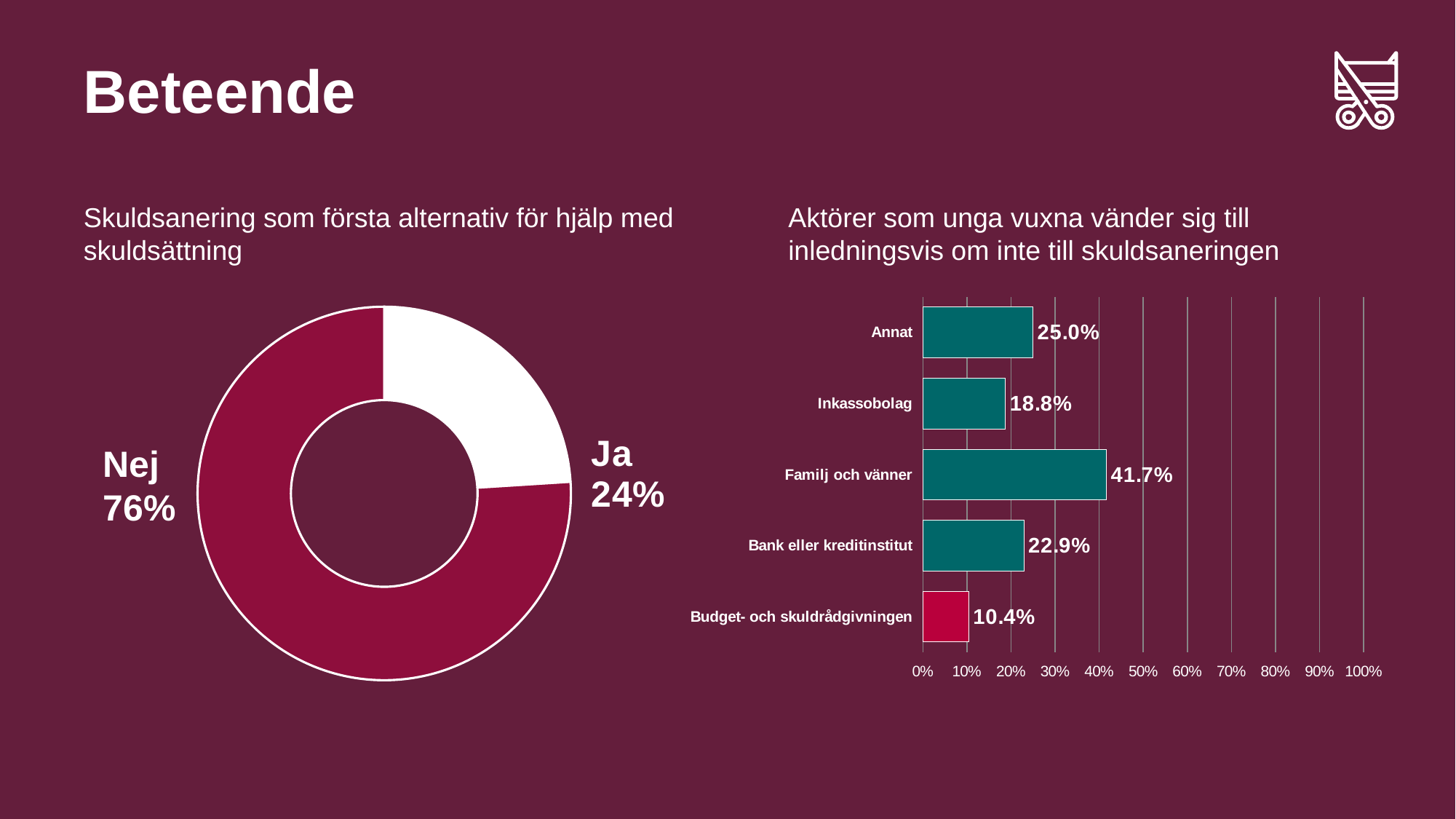
In the bar chart on the right, how many categories are shown? 5 In the bar chart on the right, which category has the highest value? Familj och vänner In the bar chart on the right, which category has the lowest value? Budget- och skuldrådgivningen In the bar chart on the right, what is the value for Familj och vänner? 41.7% What kind of chart is on the right side of the slide? Bar chart In the bar chart on the right, which is larger: Annat or Inkassobolag? Annat In the bar chart on the right, what is the value for Budget- och skuldrådgivningen? 10.4% In the bar chart on the right, which bar is shown in a different colour from the others? Budget- och skuldrådgivningen In the bar chart on the right, what is the value for Inkassobolag? 18.8% In the doughnut chart on the left, what share is Ja? 24% In the bar chart on the right, what is the difference between Annat and Bank eller kreditinstitut? 2.1% In the doughnut chart on the left, what share is Nej? 76%